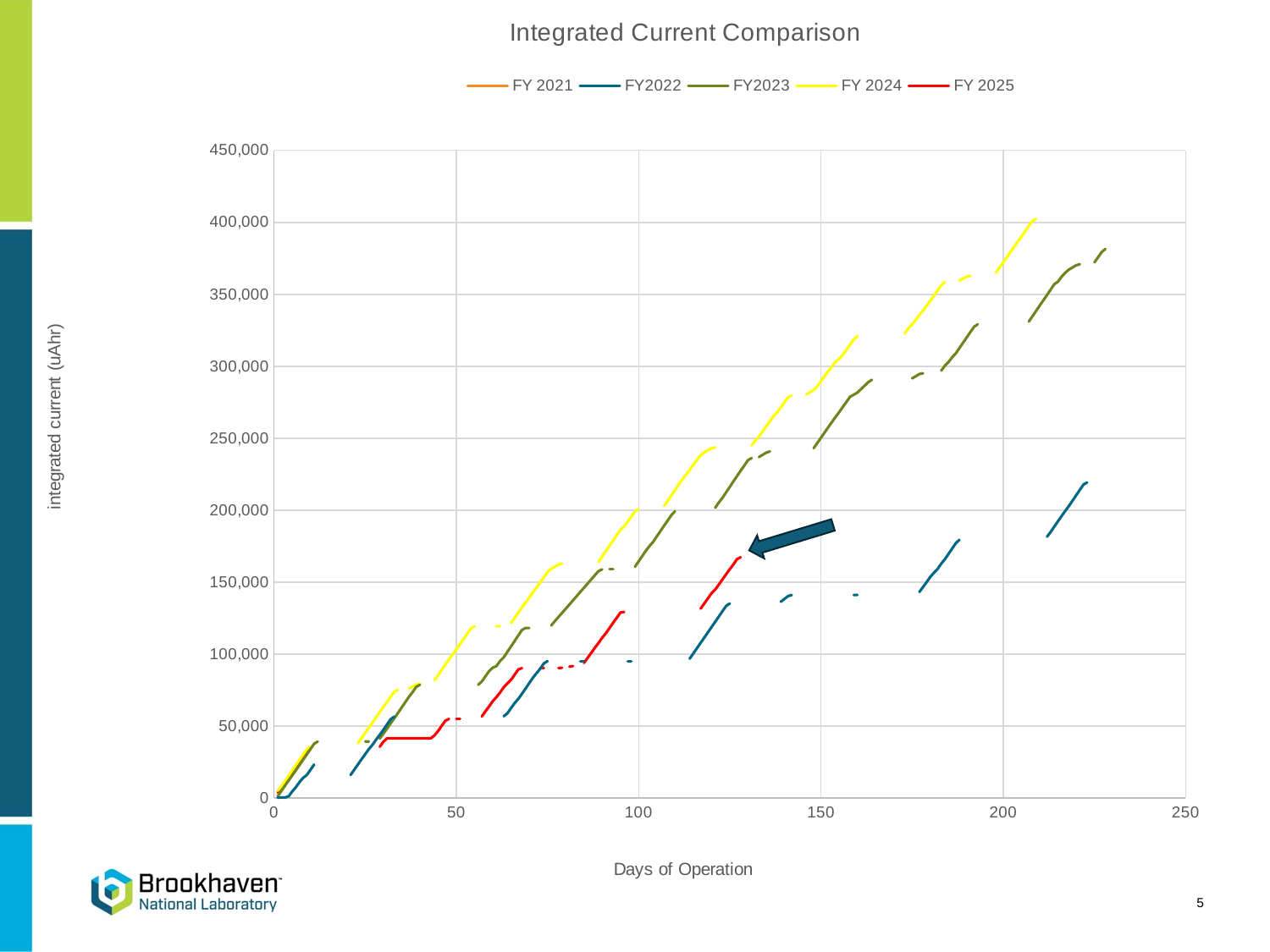
What is the label of the y axis? integrated current (uAhr) Do the integrated current values rise or fall as days of operation increase? rise At 100 days of operation, which series has the larger integrated current, FY 2024 or FY2023? FY 2024 Is the value for FY 2024 at 200 days of operation greater or less than 350,000? greater Which series reaches the highest integrated current on the chart? FY 2024 Is the final value for FY 2025 (around 128 days) greater or less than 150,000? greater What is the title of the chart? Integrated Current Comparison At 150 days of operation, which series has the larger integrated current, FY2023 or FY2022? FY2023 How many series does the legend list? 5 What kind of chart is shown on the slide? line chart Is the final value for FY2022 (around 222 days) greater or less than 200,000? greater